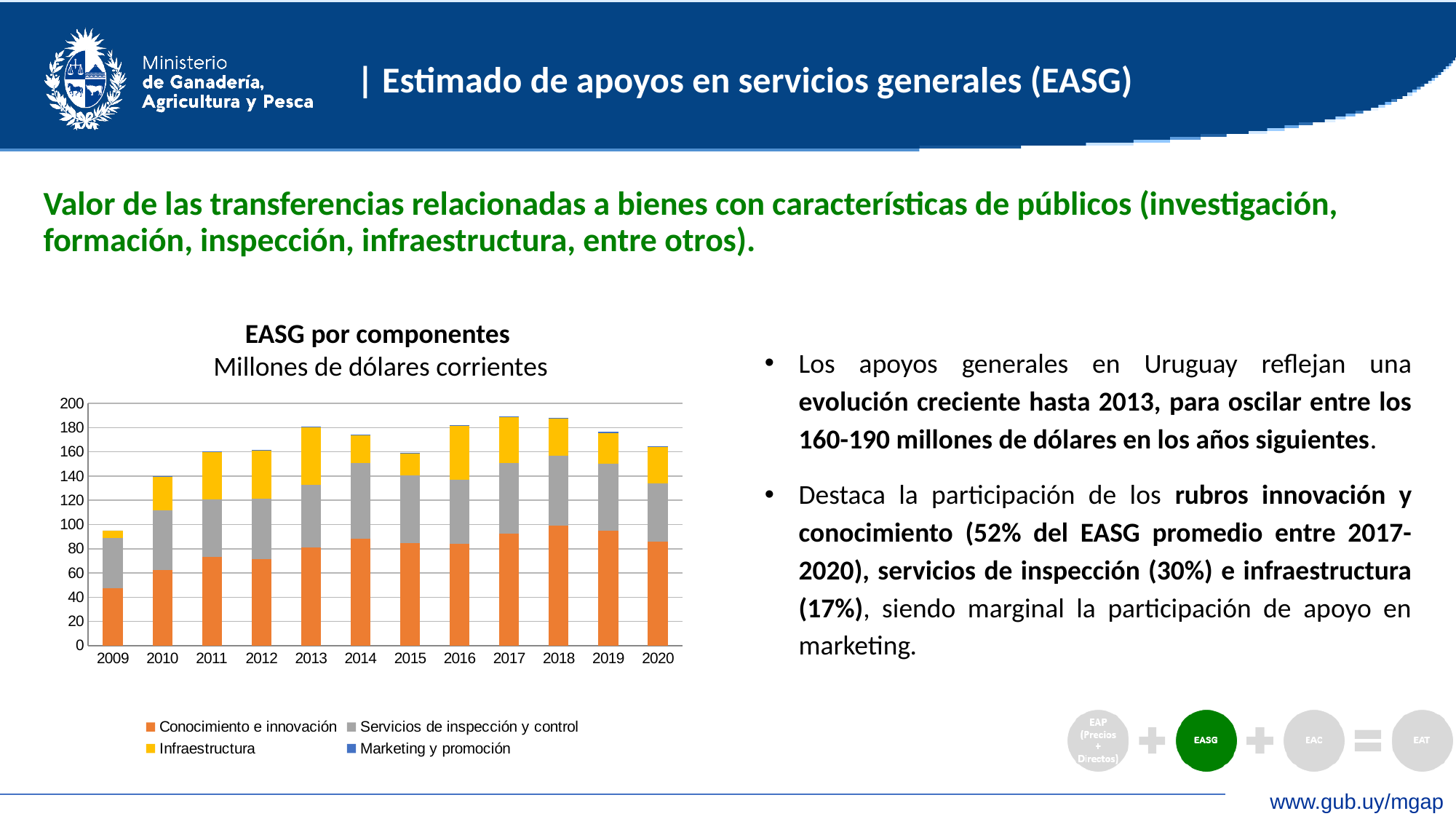
Is the total bar for 2013 in the 'EASG por componentes' chart greater or less than 160? greater Do the total bars in the 'EASG por componentes' chart rise or fall from 2009 to 2013? rise How many series does the legend of the 'EASG por componentes' chart list? 4 Which series is shown in orange in the 'EASG por componentes' chart? Conocimiento e innovación What kind of chart is 'EASG por componentes'? stacked bar chart What unit is given in the subtitle of the 'EASG por componentes' chart? Millones de dólares corrientes How many years are shown on the x axis of the 'EASG por componentes' chart? 12 Is the total bar for 2009 in the 'EASG por componentes' chart greater or less than 100? less Which year has the lowest total bar in the 'EASG por componentes' chart? 2009 Is the total bar for 2017 in the 'EASG por componentes' chart greater or less than 180? greater In the 'EASG por componentes' chart, which year has the larger total bar, 2010 or 2017? 2017